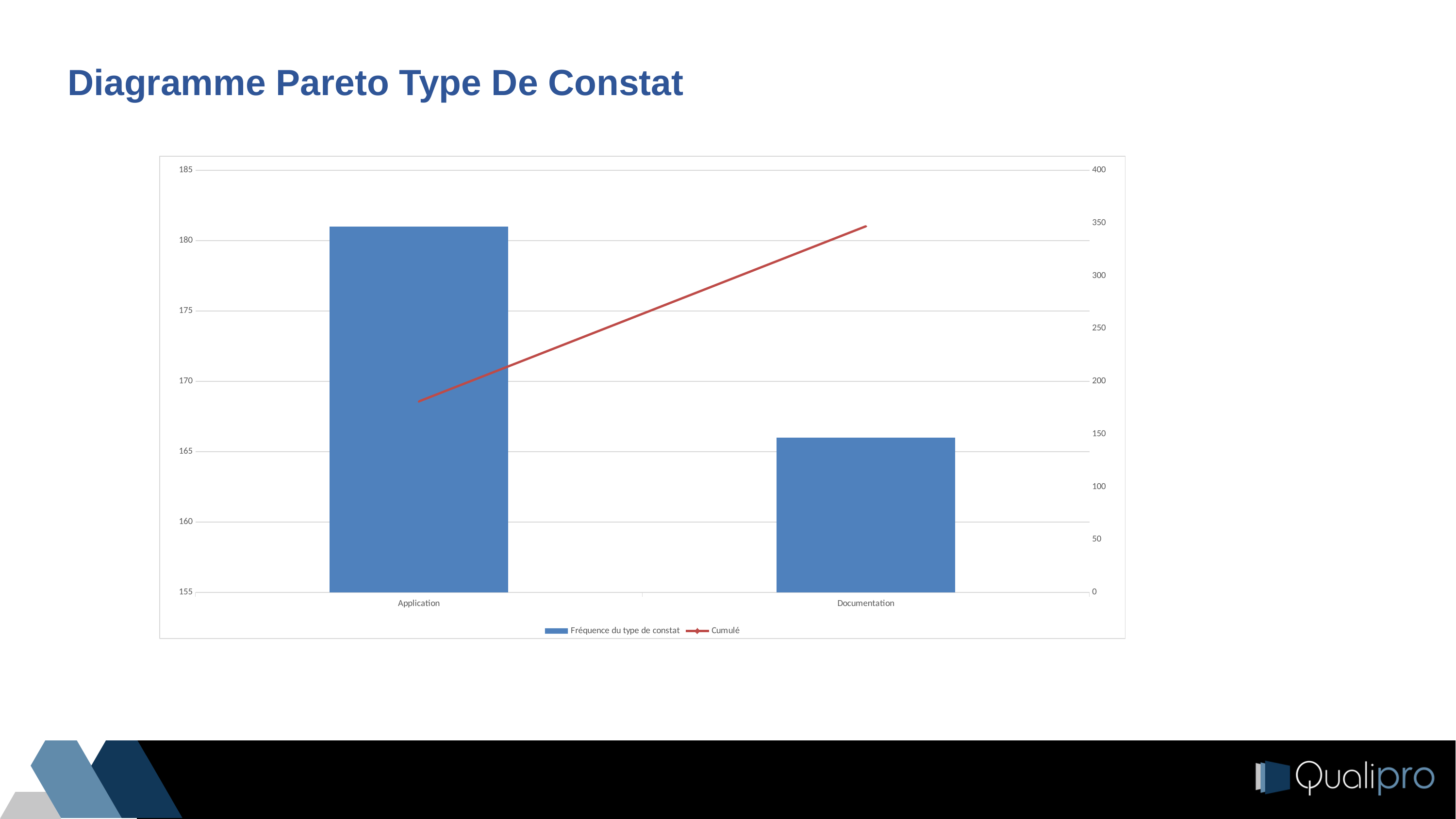
What are the two series named in the chart's legend? Fréquence du type de constat and Cumulé On the right-hand axis, is the Cumulé value for Documentation greater or less than 300? greater Is the Fréquence du type de constat value for Documentation greater or less than 170? less What kind of chart is shown on the slide? bar chart with a line Is the Fréquence du type de constat value for Application greater or less than 175? greater Which has a larger Fréquence du type de constat, Application or Documentation? Application Which category has the lowest Fréquence du type de constat bar? Documentation Does the Cumulé line rise or fall from Application to Documentation? rise How many categories are shown on the x axis of the chart? 2 How many series does the chart's legend list? 2 Which category has the highest Fréquence du type de constat bar? Application